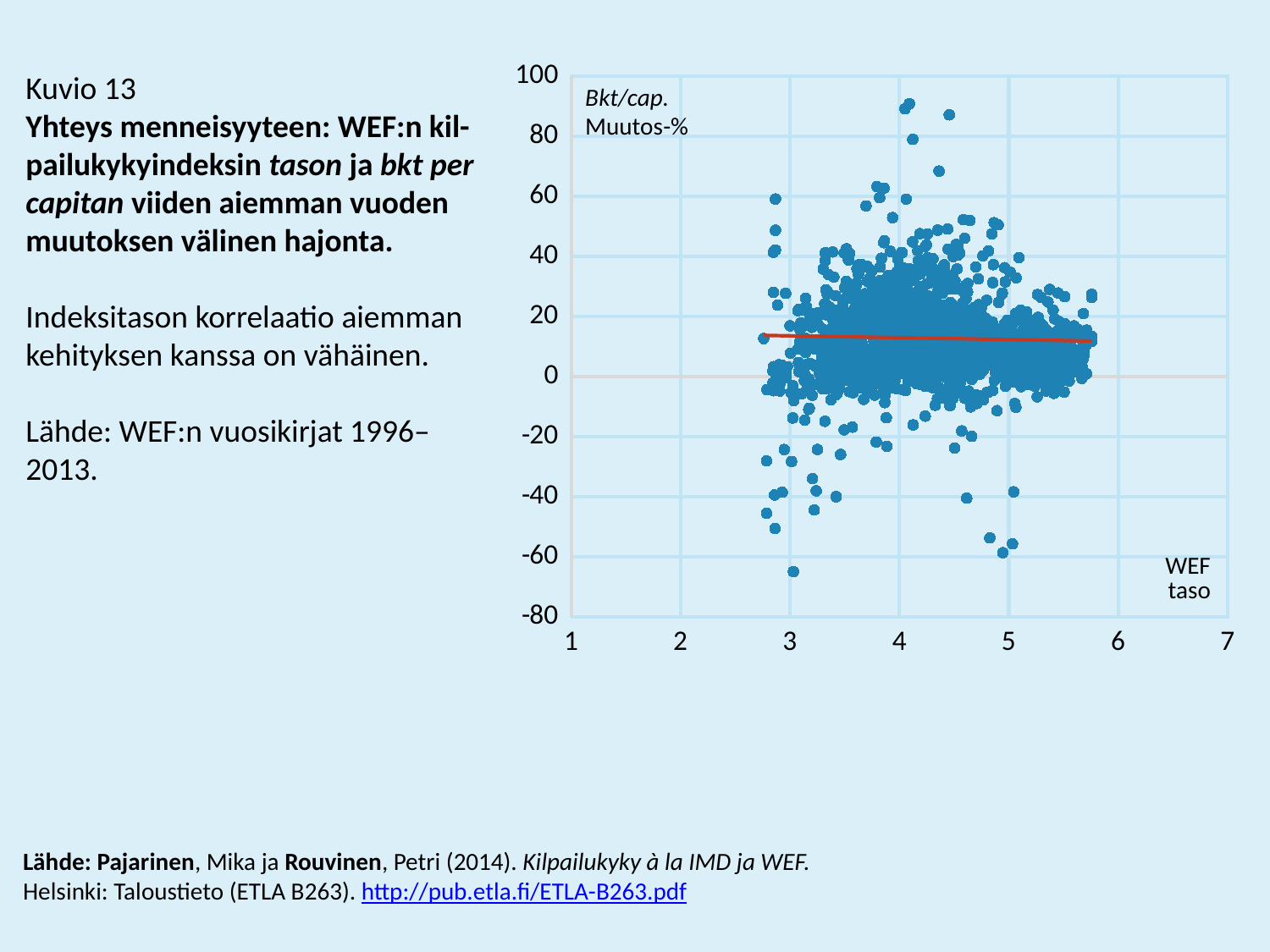
Is the lowest plotted point in the chart greater or less than -60? less Is the red trend line in the chart above or below 0 on the vertical axis? above What is the lowest value shown on the vertical axis of the chart? -80 Does the red trend line in the chart rise steeply, fall steeply, or stay roughly flat as the WEF level increases? Roughly flat What kind of chart is shown on the slide? Scatter chart What is the label of the vertical axis of the chart? Bkt/cap. Muutos-% What is the highest value shown on the horizontal axis of the chart? 7 Is the highest plotted point in the chart greater or less than 80? greater What is the highest value shown on the vertical axis of the chart? 100 What is the label of the horizontal axis of the chart? WEF taso